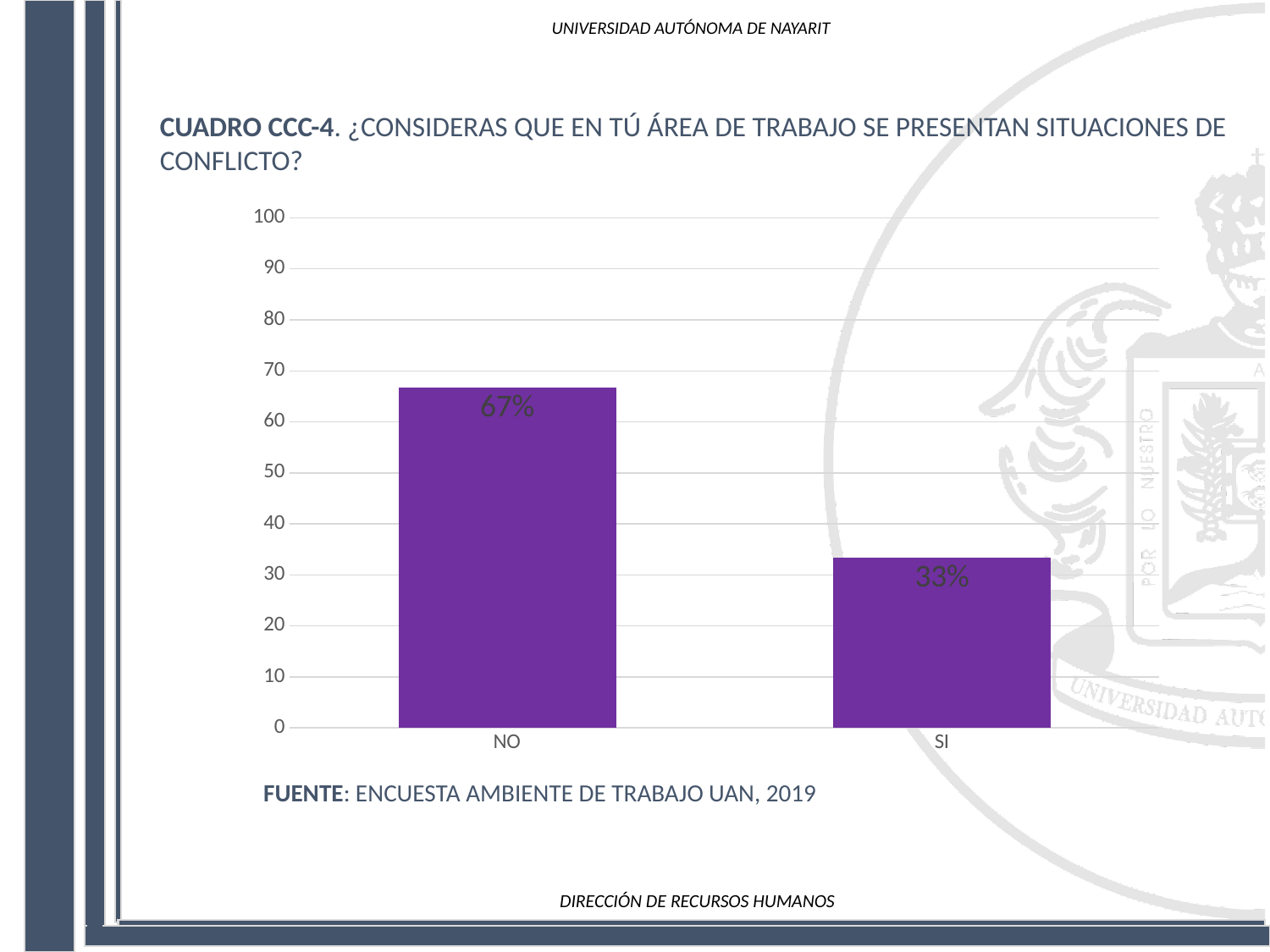
What is the source cited below the chart? ENCUESTA AMBIENTE DE TRABAJO UAN, 2019 Which category has the lowest value? SI What is the value for SI? 33% Which is larger, the value for NO or the value for SI? NO What is the value for NO? 67% What is the difference between the values for NO and SI? 34% Is the value for NO greater or less than 60? greater Is the value for SI greater or less than 40? less Which category has the highest value? NO What is the maximum value shown on the vertical axis? 100 What kind of chart is shown on the slide? bar chart How many categories are shown on the x axis? 2